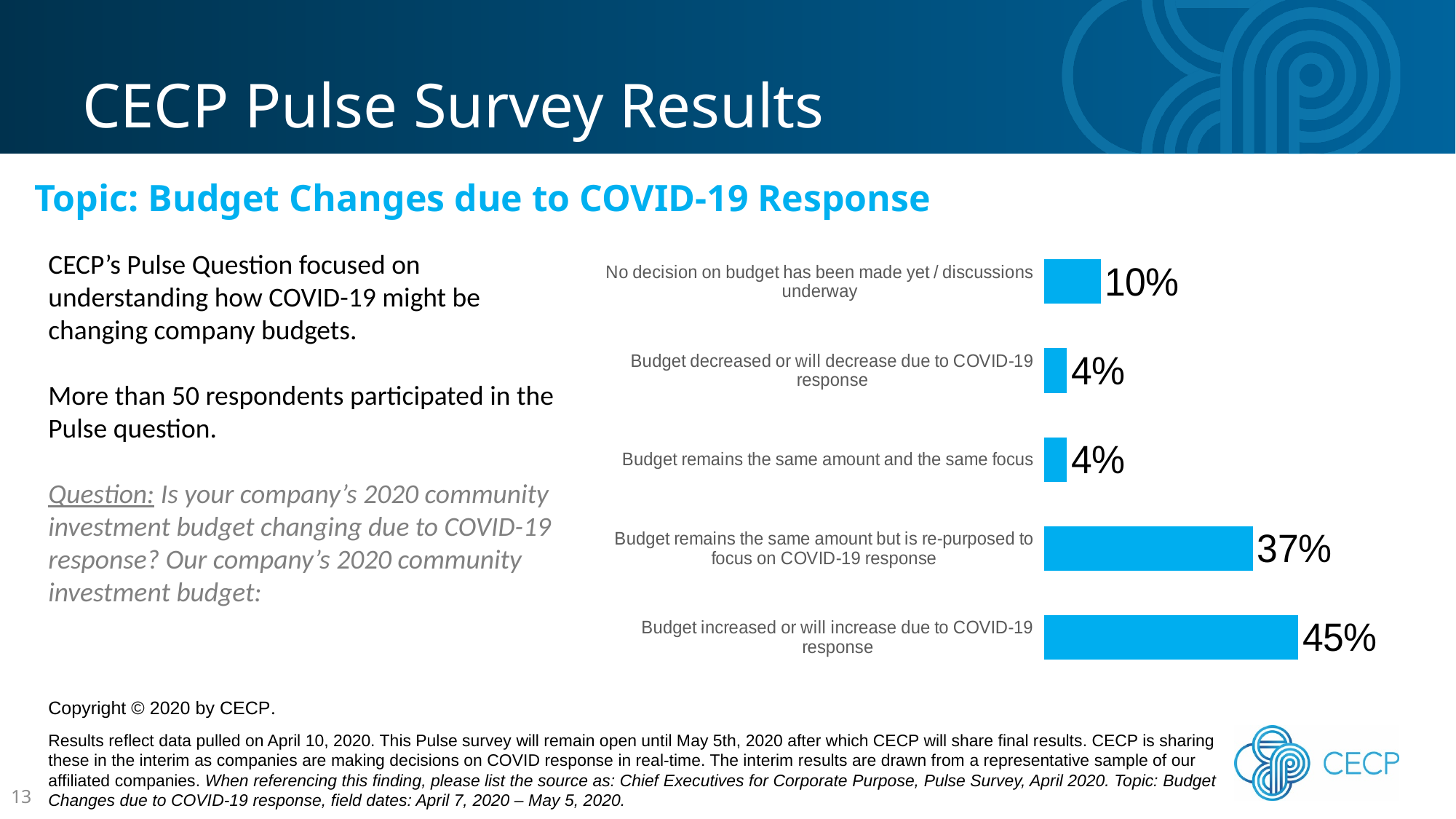
What is the difference in percentage points between 'Budget increased or will increase due to COVID-19 response' and 'Budget remains the same amount but is re-purposed to focus on COVID-19 response'? 8 What percentage of respondents said their budget remains the same amount but is re-purposed to focus on COVID-19 response? 37% Which two response categories share the same percentage value? Budget decreased or will decrease due to COVID-19 response; Budget remains the same amount and the same focus What kind of chart is shown on the slide? Bar chart What percentage of respondents said no decision on budget has been made yet / discussions underway? 10% How many response categories are shown in the chart? 5 Which response category has the highest percentage? Budget increased or will increase due to COVID-19 response What percentage of respondents said their budget increased or will increase due to COVID-19 response? 45% What is the difference in percentage points between 'No decision on budget has been made yet / discussions underway' and 'Budget remains the same amount and the same focus'? 6 Which is larger: the percentage for 'No decision on budget has been made yet / discussions underway' or for 'Budget decreased or will decrease due to COVID-19 response'? No decision on budget has been made yet / discussions underway What colour are the bars in the chart? Blue What percentage of respondents said their budget decreased or will decrease due to COVID-19 response? 4%